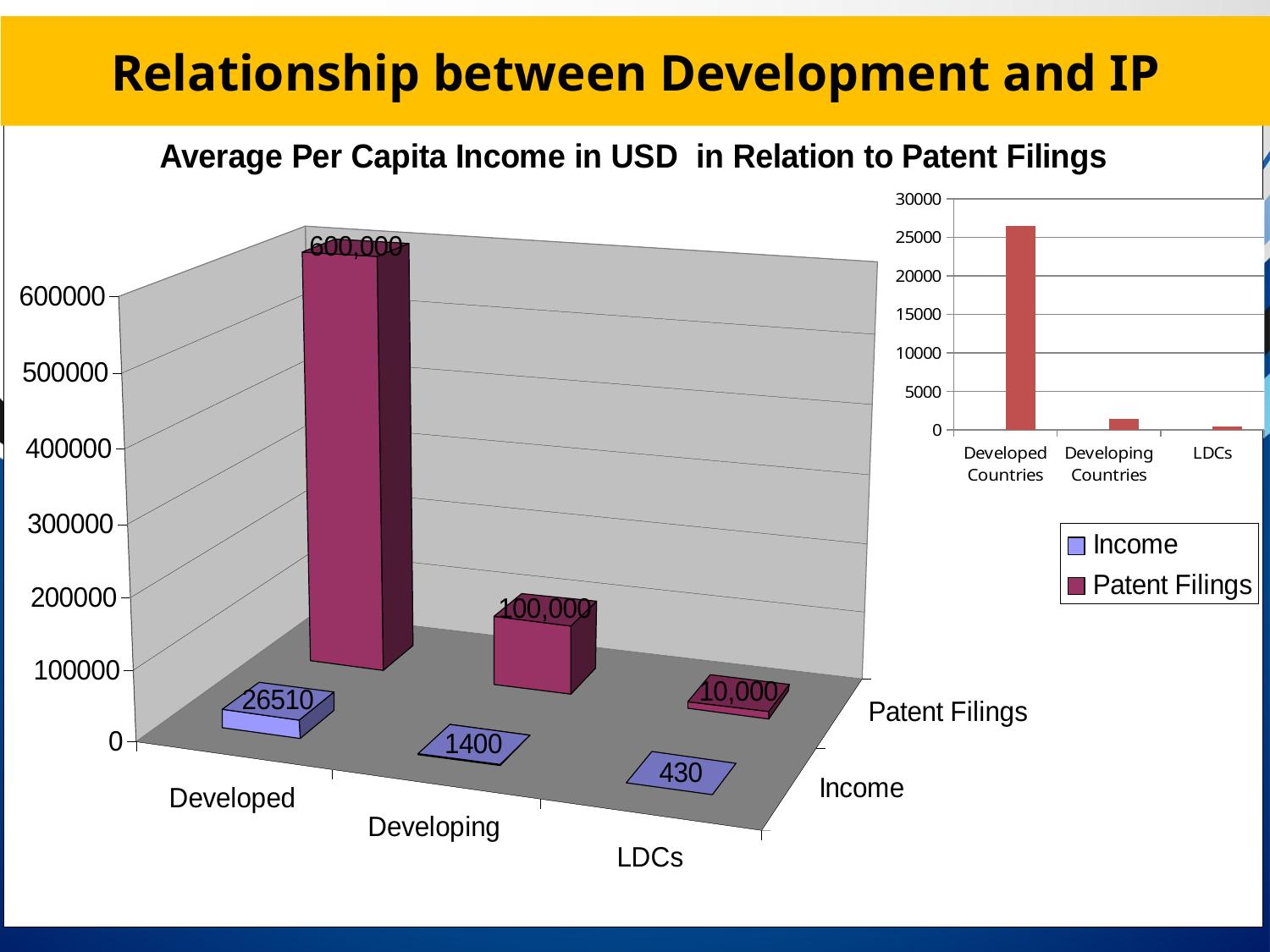
In the large chart, which category has the lowest Income value? LDCs How many series does the legend of the large chart list? 2 What kind of chart is the small chart in the top right? bar chart In the large chart, what is the Patent Filings value for Developing? 100,000 In the large chart, what is the Patent Filings value for LDCs? 10,000 In the small chart in the top right, is the value for Developed Countries greater or less than 20000? greater In the large chart, what is the difference between the Income values for Developed and Developing? 25110 In the large chart, what is the Income value for Developed? 26510 How many categories are shown on the x axis of the large chart? 3 In the large chart, which category has the highest Patent Filings value? Developed In the large chart, which is larger: the Patent Filings value for Developing or for LDCs? Developing In the large chart, what is the Income value for LDCs? 430